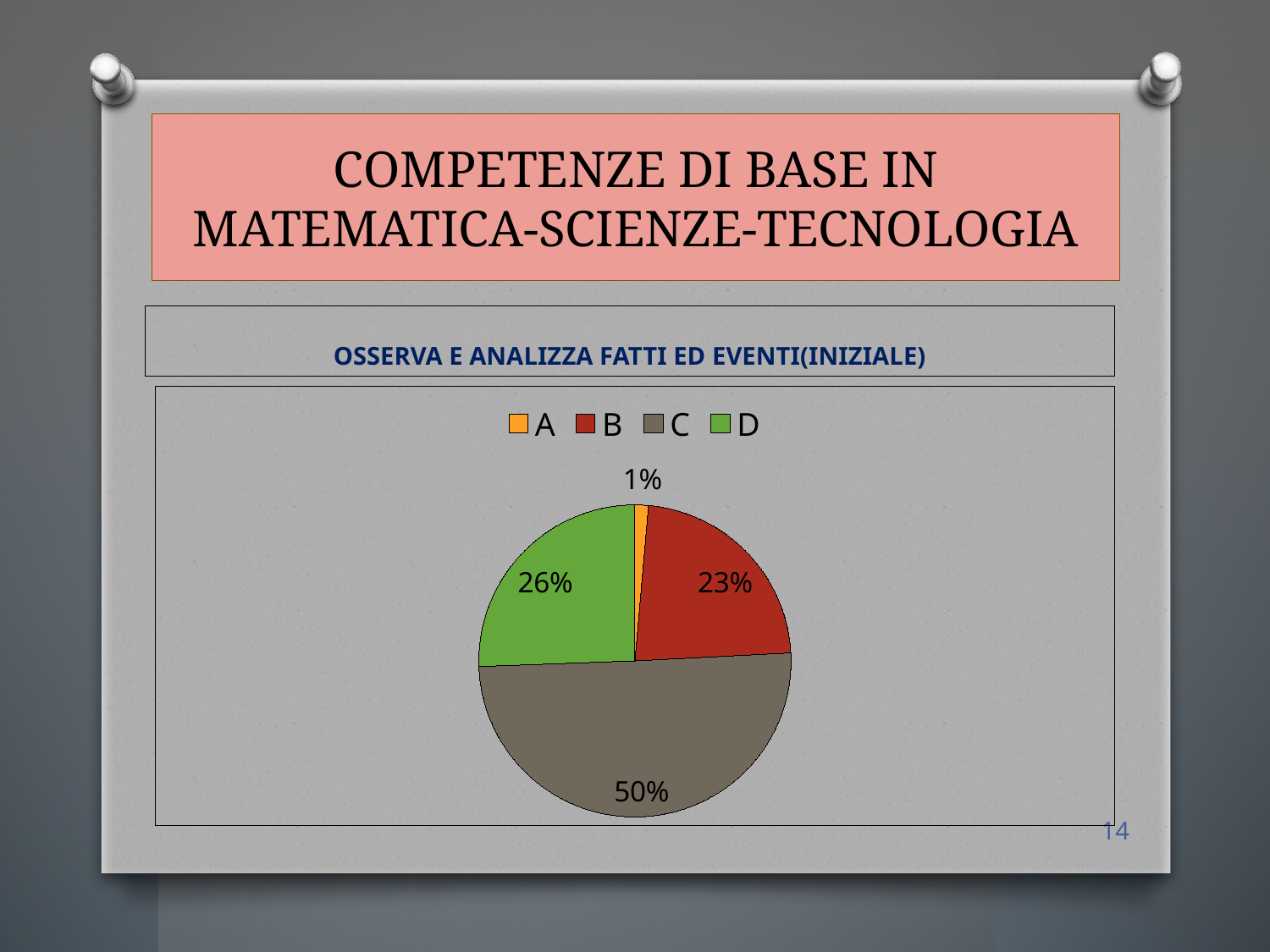
What percentage does slice C represent? 50% What percentage does slice D represent? 26% Which is larger, the share for B or the share for D? D How many categories does the legend list? 4 What percentage does slice A represent? 1% What percentage does slice B represent? 23% Which category has the largest share of the pie? C What kind of chart is shown on the slide? pie chart What colour is the slice for category C? grey Which category has the smallest share of the pie? A What is the difference in percentage points between C and D? 24 How many slices does the pie chart have? 4